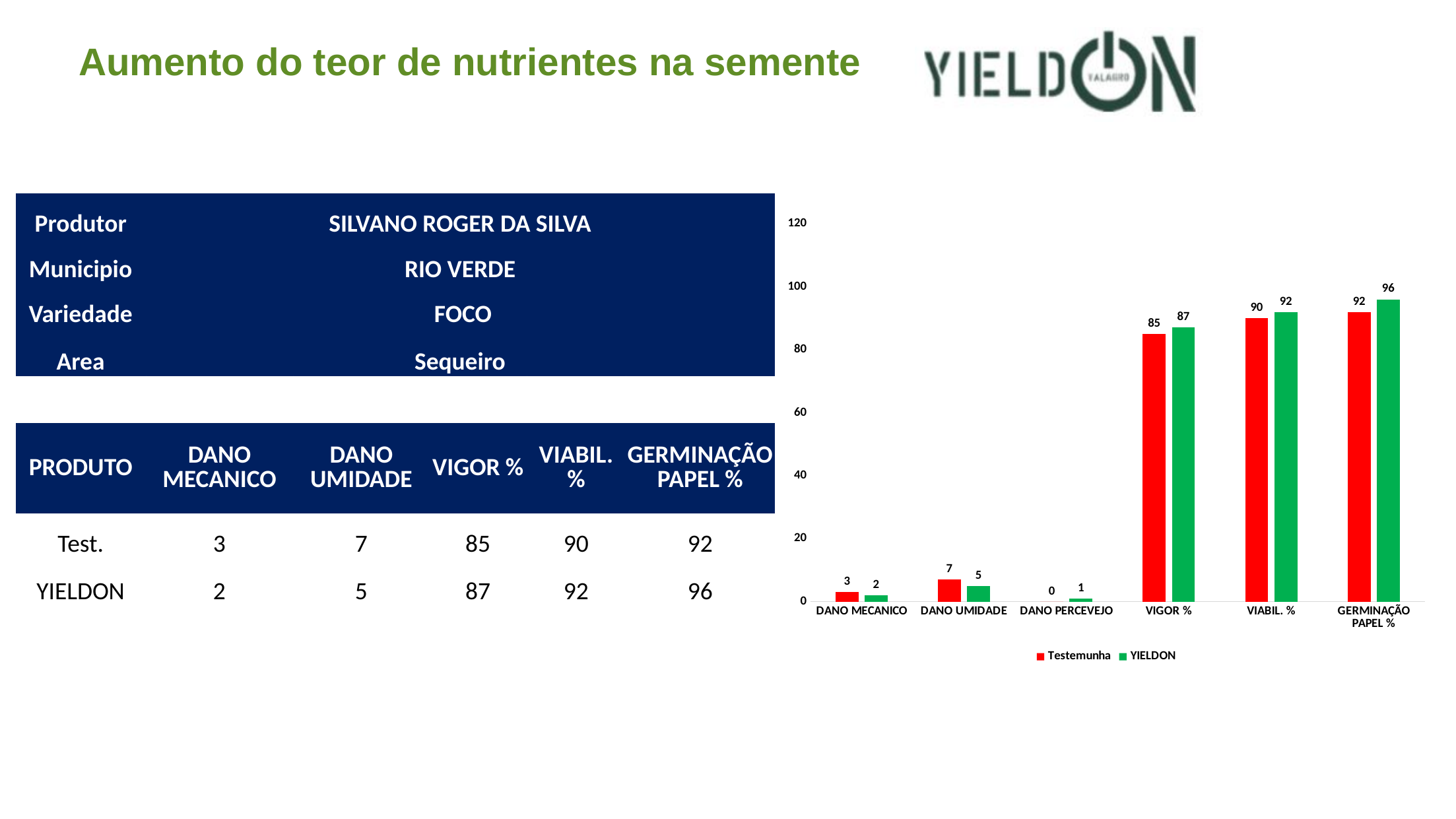
What is the YIELDON value for DANO PERCEVEJO in the chart? 1 Which category has the highest YIELDON value in the chart? GERMINAÇÃO PAPEL % What is the YIELDON value for GERMINAÇÃO PAPEL % in the chart? 96 How many categories are shown on the x axis of the chart? 6 What is the difference between the YIELDON and Testemunha values for GERMINAÇÃO PAPEL %? 4 How many series does the chart legend list? 2 What kind of chart is shown on the slide? bar chart What colour are the YIELDON bars in the chart? green Which category has the lowest Testemunha value in the chart? DANO PERCEVEJO What is the Testemunha value for VIGOR % in the chart? 85 Is the Testemunha value for VIABIL. % greater or less than 80? greater For DANO UMIDADE, which series has the larger value, Testemunha or YIELDON? Testemunha